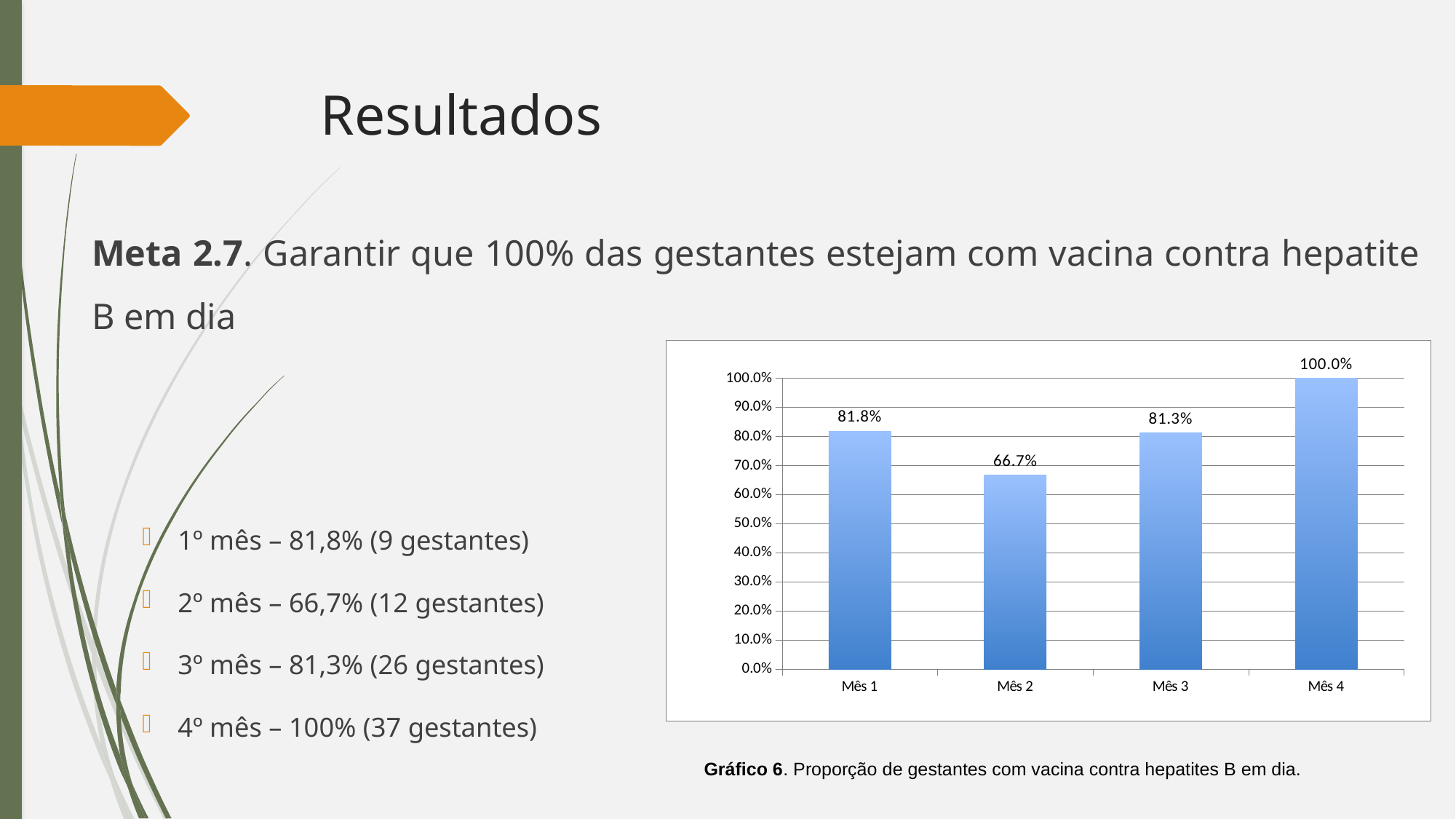
What is the value for Mês 1? 81.8% What is the difference between the values for Mês 4 and Mês 2? 33.3% Which is larger, the value for Mês 1 or the value for Mês 2? Mês 1 Is the value for Mês 2 greater or less than 70.0%? less Which month has the lowest value? Mês 2 How many months are shown on the x axis? 4 What is the value for Mês 4? 100.0% What is the value for Mês 3? 81.3% What kind of chart is shown on the slide? bar chart What is the caption of the chart? Gráfico 6. Proporção de gestantes com vacina contra hepatites B em dia. What is the value for Mês 2? 66.7% Which month has the highest value? Mês 4